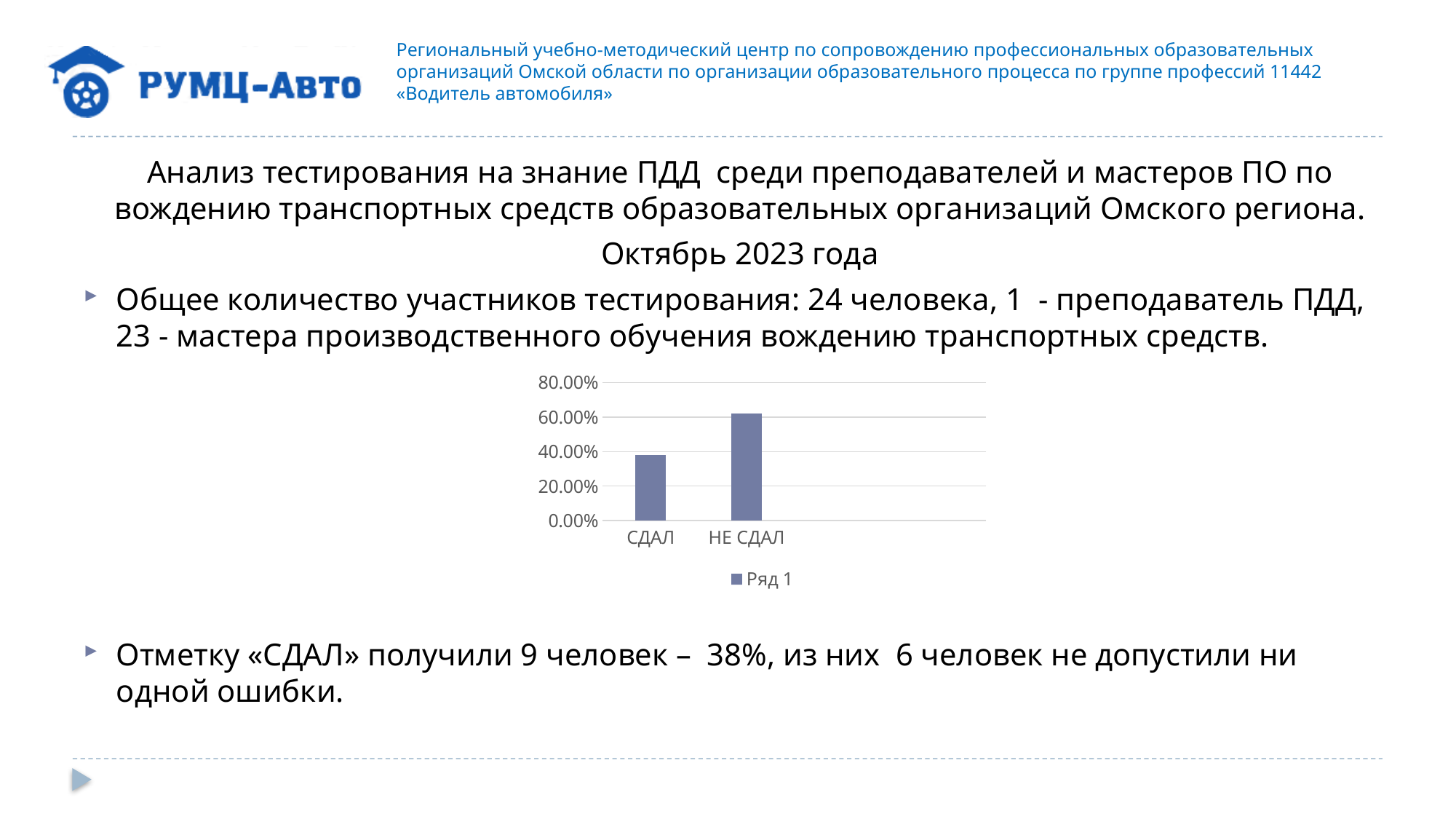
Is the value for СДАЛ greater or less than 20.00%? greater Is the value for НЕ СДАЛ greater or less than 40.00%? greater Which category has the highest bar in the chart? НЕ СДАЛ Which is larger in the chart, the value for СДАЛ or the value for НЕ СДАЛ? НЕ СДАЛ How many categories are shown on the x axis of the chart? 2 Is the value for СДАЛ greater or less than 60.00%? less How many series does the chart legend list? 1 What is the name of the series shown in the chart legend? Ряд 1 What is the highest tick label on the chart's vertical axis? 80.00% What kind of chart is shown on the slide? bar chart Which category has the lowest bar in the chart? СДАЛ